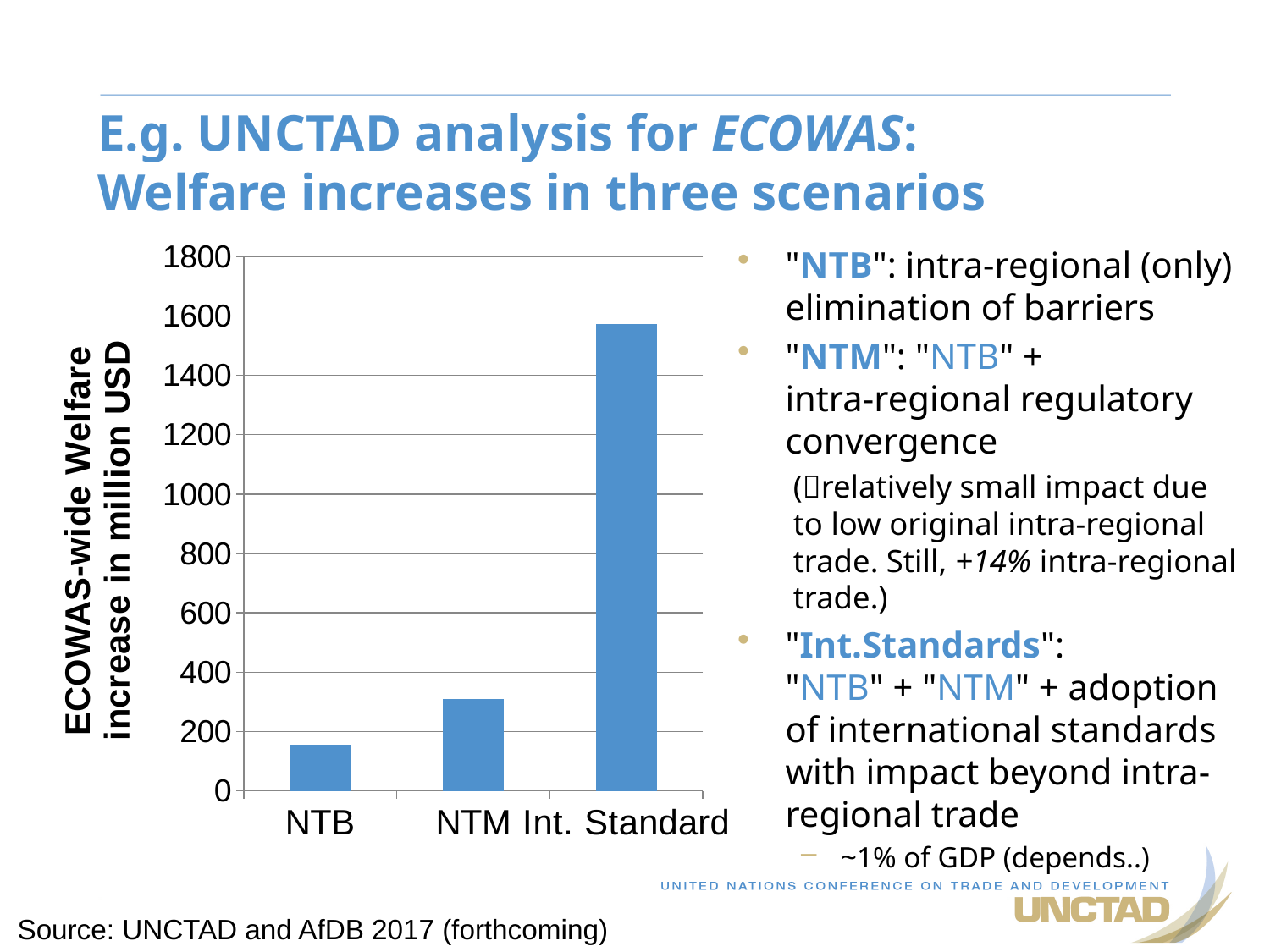
Is the value for NTM greater or less than 200? greater How many categories are shown on the x axis of the chart? 3 Which category has the lowest welfare increase in the chart? NTB Is the value for NTM greater or less than 400? less Is the value for Int. Standard greater or less than 1400? greater What is the title of the vertical axis of the chart? ECOWAS-wide Welfare increase in million USD Do the bar values rise or fall moving from left to right along the x axis? rise Which is larger in the chart, the value for NTM or the value for Int. Standard? Int. Standard Which is larger in the chart, the value for NTM or the value for NTB? NTM What kind of chart is shown on the slide? bar chart Which category has the highest welfare increase in the chart? Int. Standard